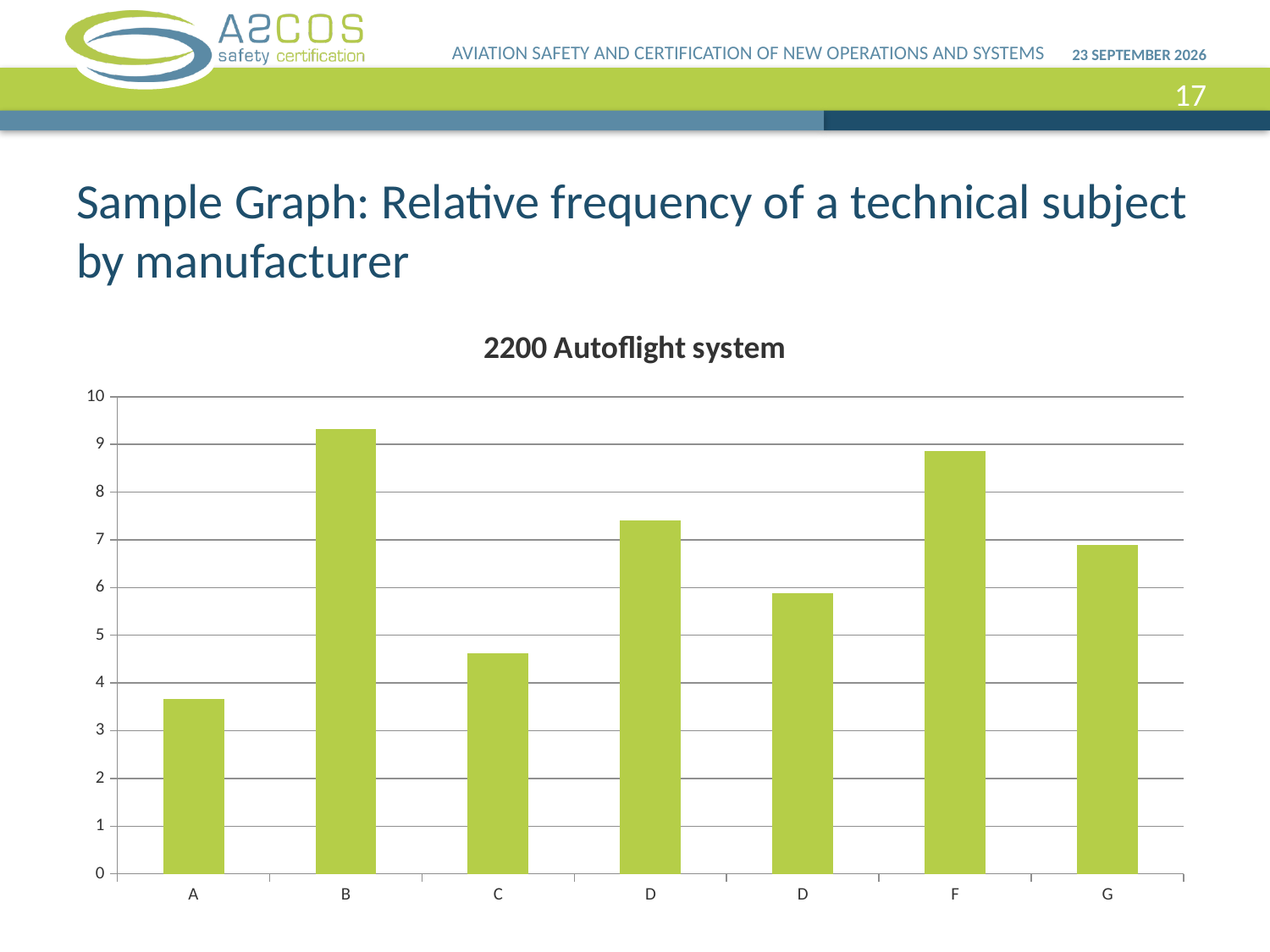
Which category has the lowest bar? A What is the title of the chart? 2200 Autoflight system Is the value for B greater or less than 9? greater Is the value for A greater or less than 4? less Which category has the highest bar? B Is the value for C greater or less than 5? less Which is larger, the value for B or the value for F? B What kind of chart is shown on the slide? bar chart Which is larger, the value for C or the value for G? G Which is larger, the value for A or the value for C? C How many bars are plotted in the chart? 7